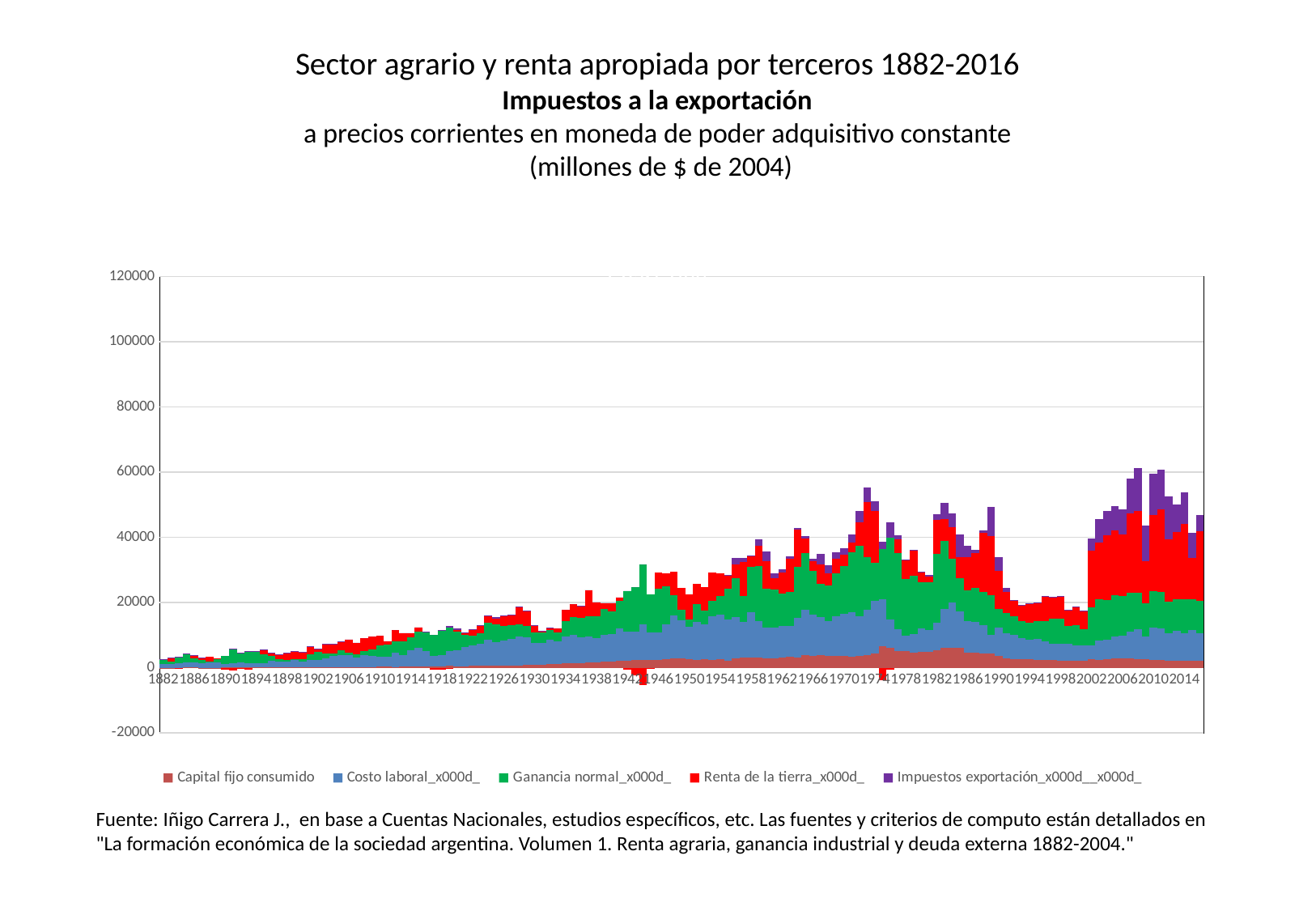
Overall, do the total stacked values rise or fall from 1882 to 2016? rise Is the total stacked value for 1998 greater or less than 40000? less Is the total stacked value for 1930 greater or less than 20000? less How many series does the legend list? 5 Is the total stacked value for 1974 greater or less than 40000? greater What kind of chart is shown on the slide? Stacked bar chart Which series is shown in purple in the legend? Impuestos exportación_x000d__x000d_ What is the first year shown on the x axis? 1882 Which series is plotted at the bottom of each stacked bar? Capital fijo consumido